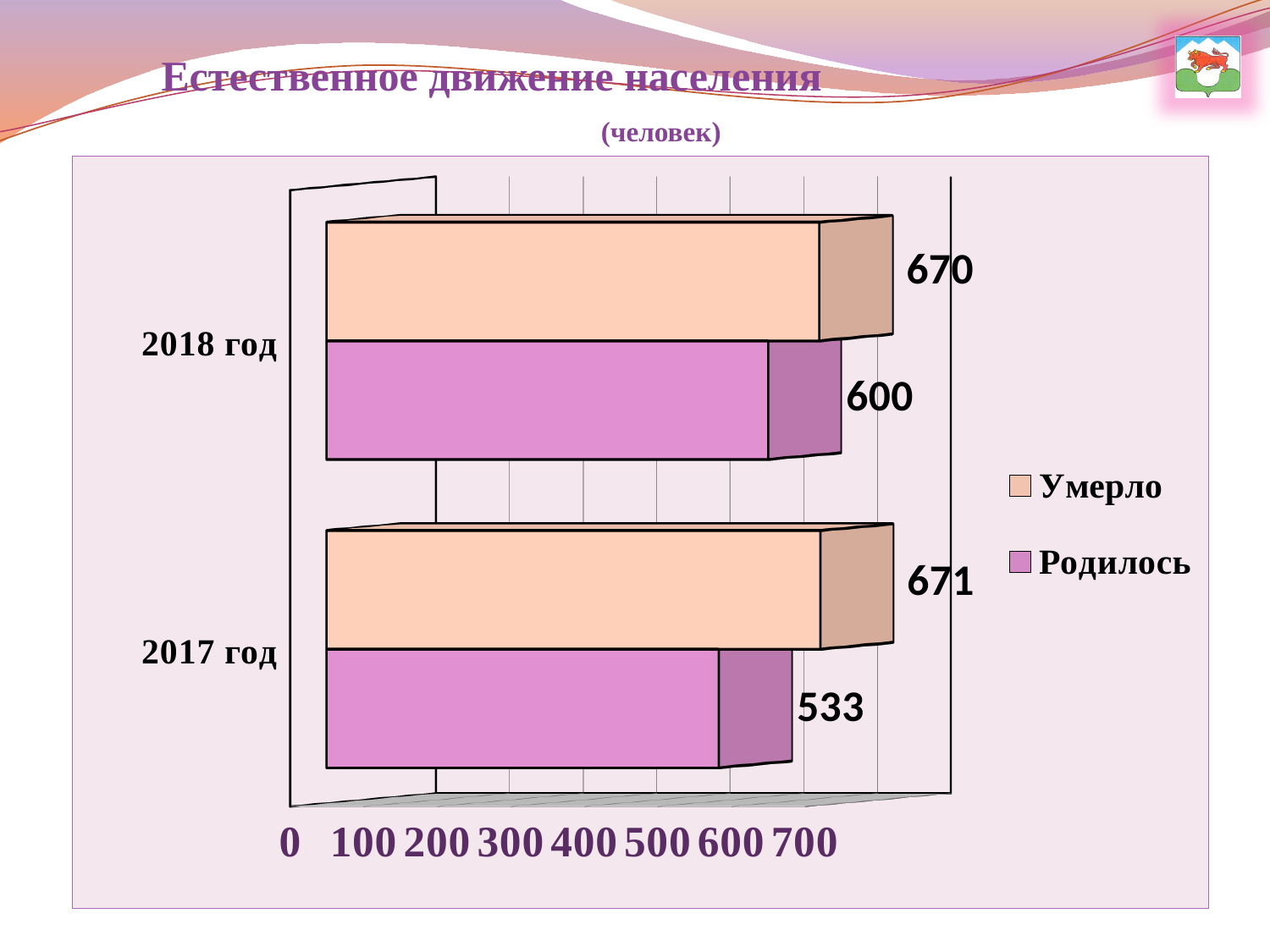
How many series does the legend list? 2 By how much did Родилось increase from 2017 год to 2018 год? 67 What kind of chart is shown on the slide? Bar chart How many categories (years) are shown on the chart? 2 What is the value for Умерло in 2018 год? 670 What is the difference between Умерло and Родилось in 2018 год? 70 What is the value for Родилось in 2018 год? 600 Which year has the lower value for Родилось? 2017 год What is the value for Родилось in 2017 год? 533 Which is larger: Родилось in 2018 год or Родилось in 2017 год? Родилось in 2018 год What is the difference between Умерло and Родилось in 2017 год? 138 What is the value for Умерло in 2017 год? 671